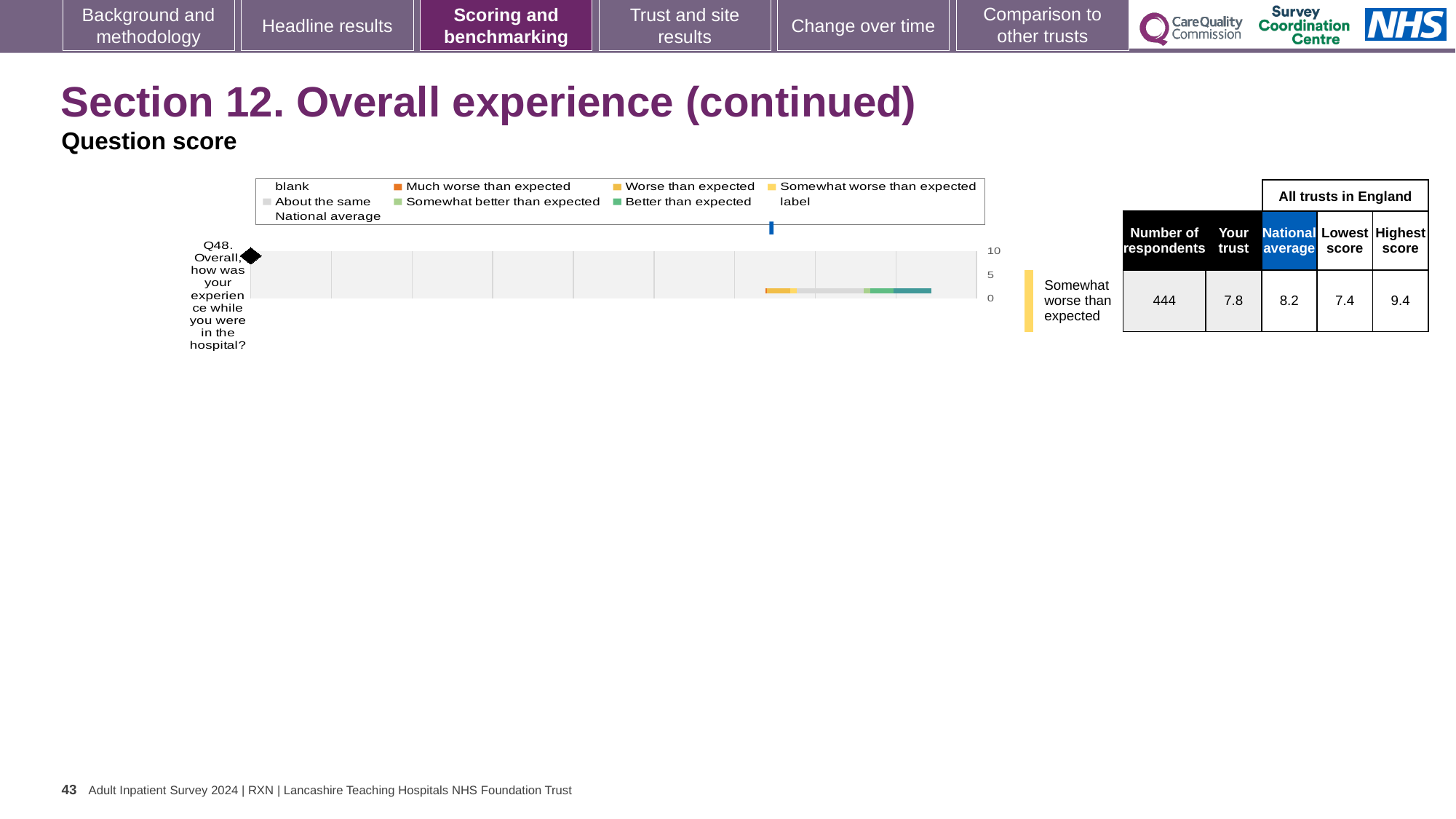
What is the highest score among all trusts in England for Q48? 9.4 What benchmark category is the trust's Q48 score assigned to? Somewhat worse than expected How many respondents answered Q48? 444 What is the 'Your trust' score for Q48 shown in the table beside the chart? 7.8 What kind of chart is used to show the Q48 question score? bar chart What is the lowest score among all trusts in England for Q48? 7.4 Which is larger for Q48, the 'Your trust' score or the national average? National average How many questions (categories) are plotted on the chart? 1 What is the highest value shown on the chart's score axis? 10 Which question is plotted on the chart? Q48. Overall, how was your experience while you were in the hospital? What is the difference between the highest score and the lowest score for Q48? 2.0 What is the national average score for Q48 shown in the table beside the chart? 8.2